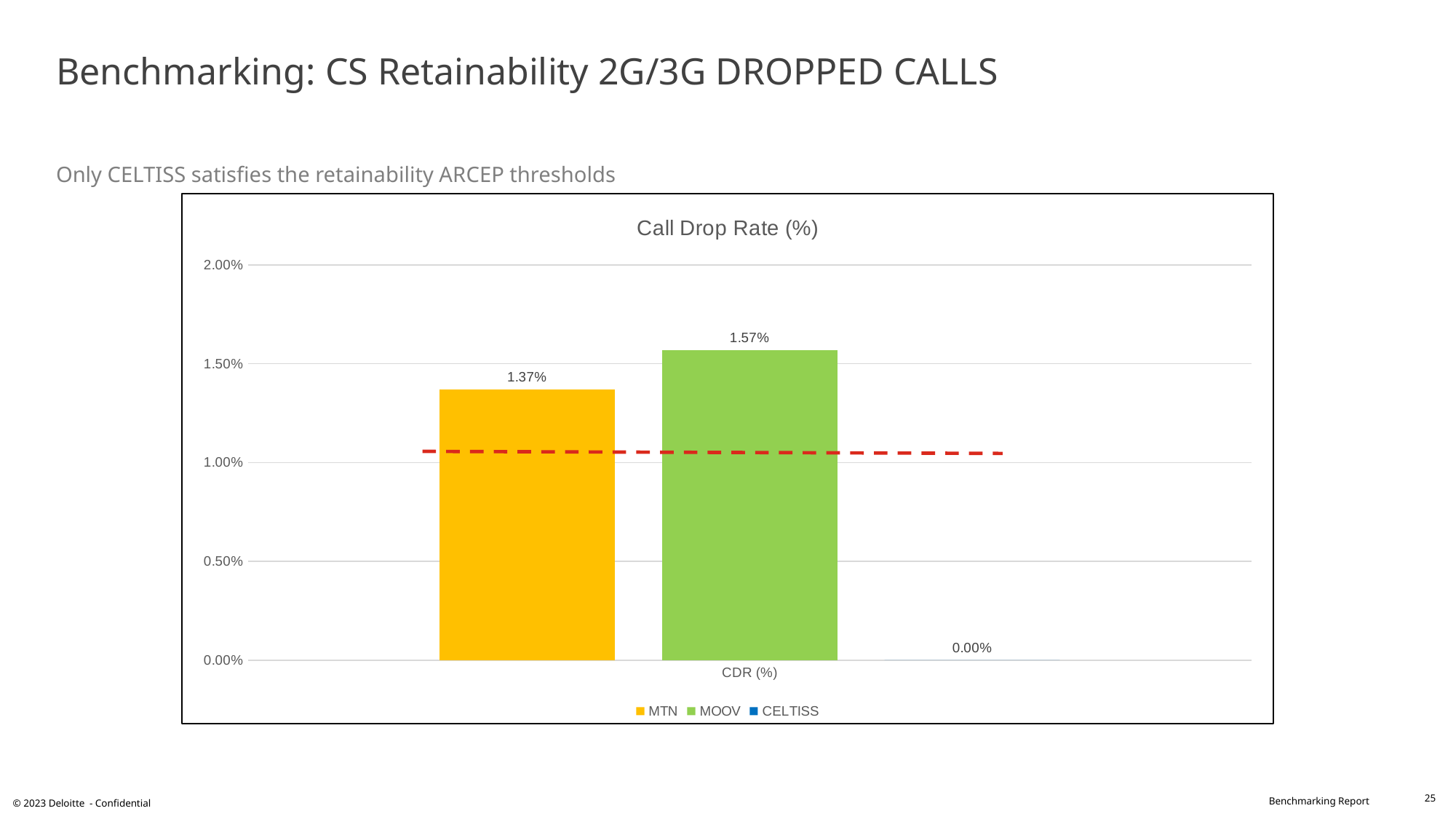
Which operator has the lowest Call Drop Rate? CELTISS Which has a higher Call Drop Rate, MTN or MOOV? MOOV Is the Call Drop Rate for MOOV greater or less than 2.00%? less Is the Call Drop Rate for MTN greater or less than 1.00%? greater How many series does the legend list? 3 What is the Call Drop Rate value for CELTISS? 0.00% Which operator has the highest Call Drop Rate? MOOV What is the Call Drop Rate value for MOOV? 1.57% What kind of chart is shown on the slide? Bar chart What is the Call Drop Rate value for MTN? 1.37% What is the title of the chart? Call Drop Rate (%) What is the difference between the Call Drop Rate of MOOV and MTN? 0.20%